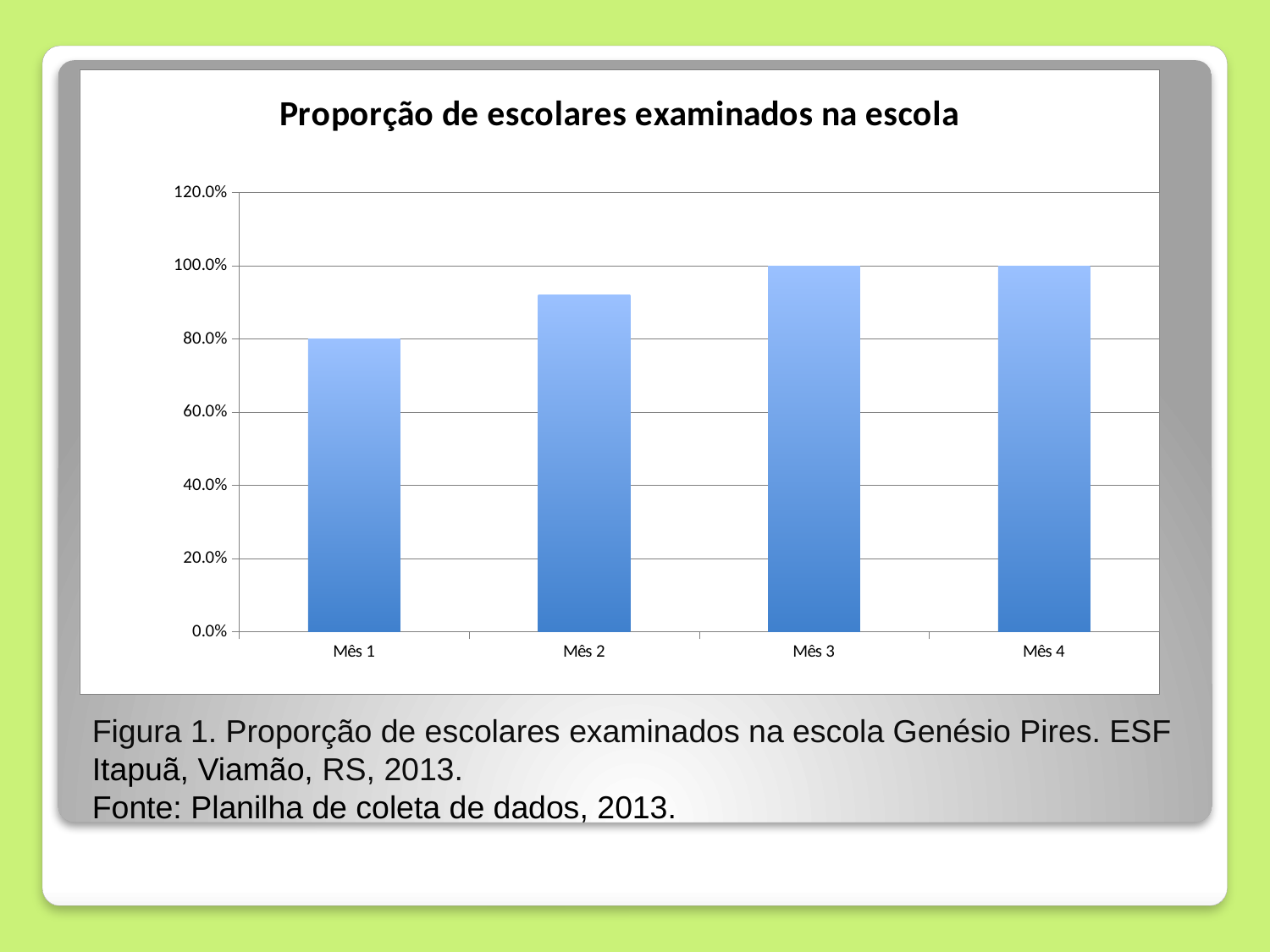
What kind of chart is shown on the slide? bar chart What is the difference between the values for Mês 3 and Mês 1? 20.0% Is the value for Mês 2 greater or less than 100.0%? less What is the value for Mês 4? 100.0% Which is larger, the value for Mês 1 or the value for Mês 2? Mês 2 Is the value for Mês 2 greater or less than 80.0%? greater Which month has the lowest value? Mês 1 How many months (categories) are shown on the x axis? 4 Do the values rise or fall from Mês 1 to Mês 3? rise What is the title of the chart? Proporção de escolares examinados na escola What is the value for Mês 3? 100.0% What is the value for Mês 1? 80.0%